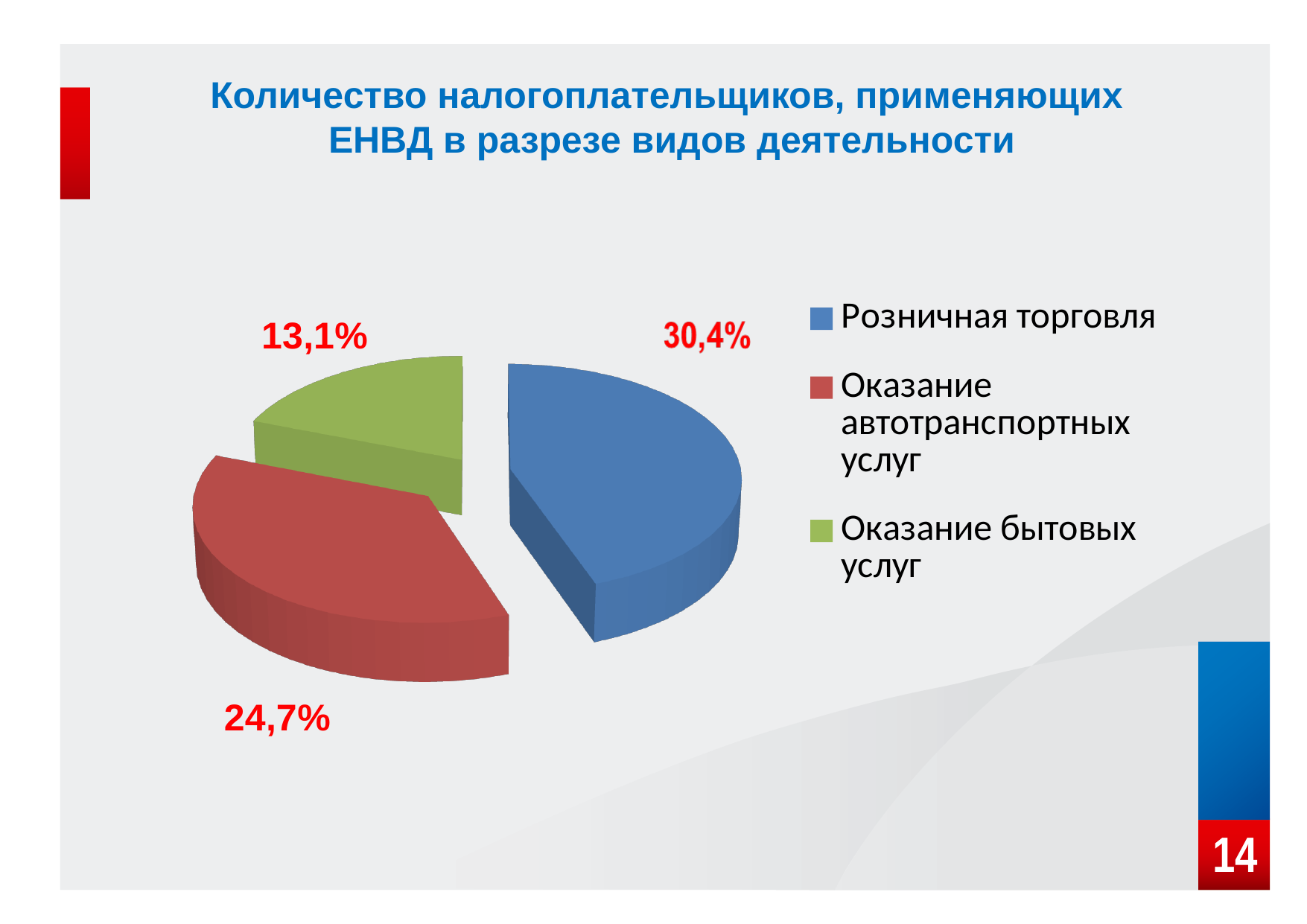
How many slices does the pie chart have? 3 What percentage is shown for Оказание автотранспортных услуг? 24,7% Which category has the largest share of the pie? Розничная торговля What is the title of the chart on the slide? Количество налогоплательщиков, применяющих ЕНВД в разрезе видов деятельности What is the difference in percentage points between Розничная торговля and Оказание бытовых услуг? 17,3 How many entries does the legend list? 3 Which is larger: the share for Оказание автотранспортных услуг or for Оказание бытовых услуг? Оказание автотранспортных услуг What colour is the slice for Оказание автотранспортных услуг? Red What percentage is shown for Оказание бытовых услуг? 13,1% What type of chart is shown on the slide? Pie chart What percentage is shown for Розничная торговля? 30,4% Which category has the smallest share of the pie? Оказание бытовых услуг